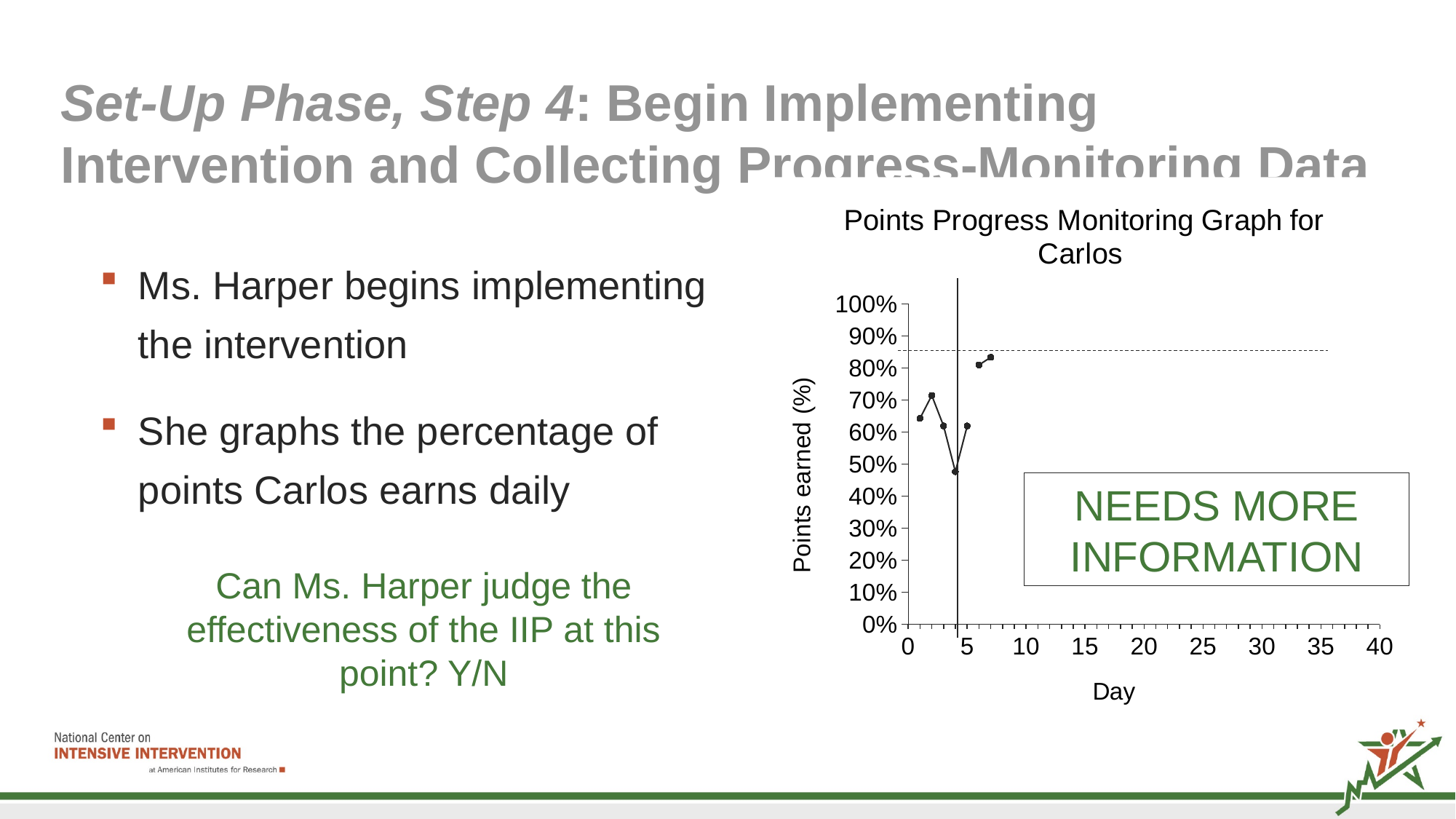
Is the value for Day 6 greater or less than 70%? greater On which day is the lowest percentage of points earned plotted? Day 4 What is the label of the y axis on the chart? Points earned (%) What kind of chart is the Points Progress Monitoring Graph for Carlos? line chart Is the value for Day 4 greater or less than 50%? less Is the value for Day 1 greater or less than 60%? greater How many data points are plotted on the Points Progress Monitoring Graph for Carlos? 7 Which is larger, the value for Day 2 or the value for Day 4? Day 2 Do the plotted values rise or fall from Day 4 to Day 7? rise What is the title of the chart on the slide? Points Progress Monitoring Graph for Carlos